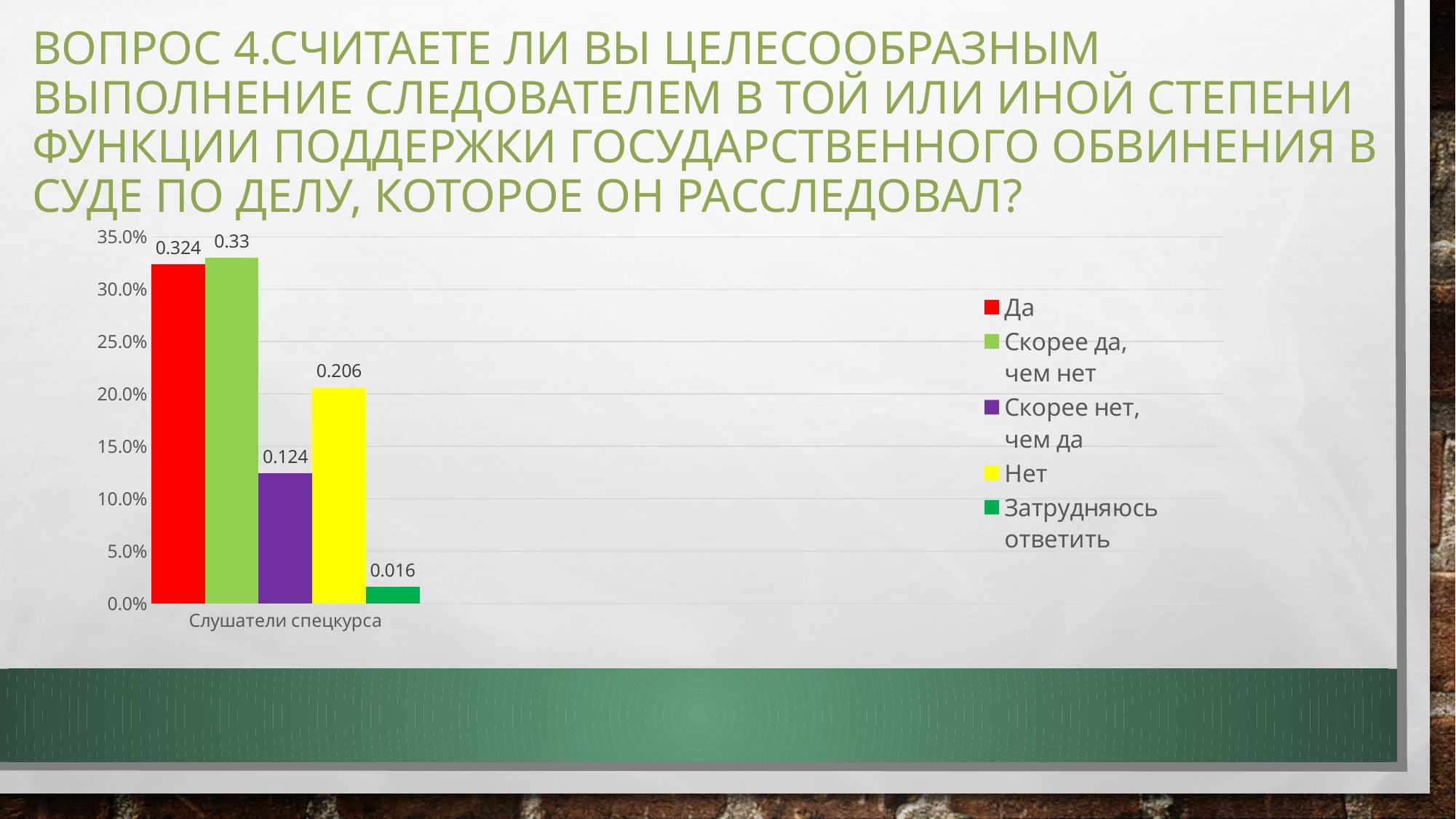
Which is larger, the value for "Да" or the value for "Нет"? Да What value is shown for the series "Нет"? 0.206 What kind of chart is shown on the slide? bar chart What value is shown for the series "Скорее нет, чем да"? 0.124 Is the value for "Да" greater or less than 30.0%? greater What value is shown for the series "Скорее да, чем нет"? 0.33 What value is shown for the series "Затрудняюсь ответить"? 0.016 What value is shown for the series "Да"? 0.324 Which series has the lowest value? Затрудняюсь ответить How many series does the legend list? 5 What is the difference between the values for "Нет" and "Скорее нет, чем да"? 0.082 Which series has the highest value? Скорее да, чем нет